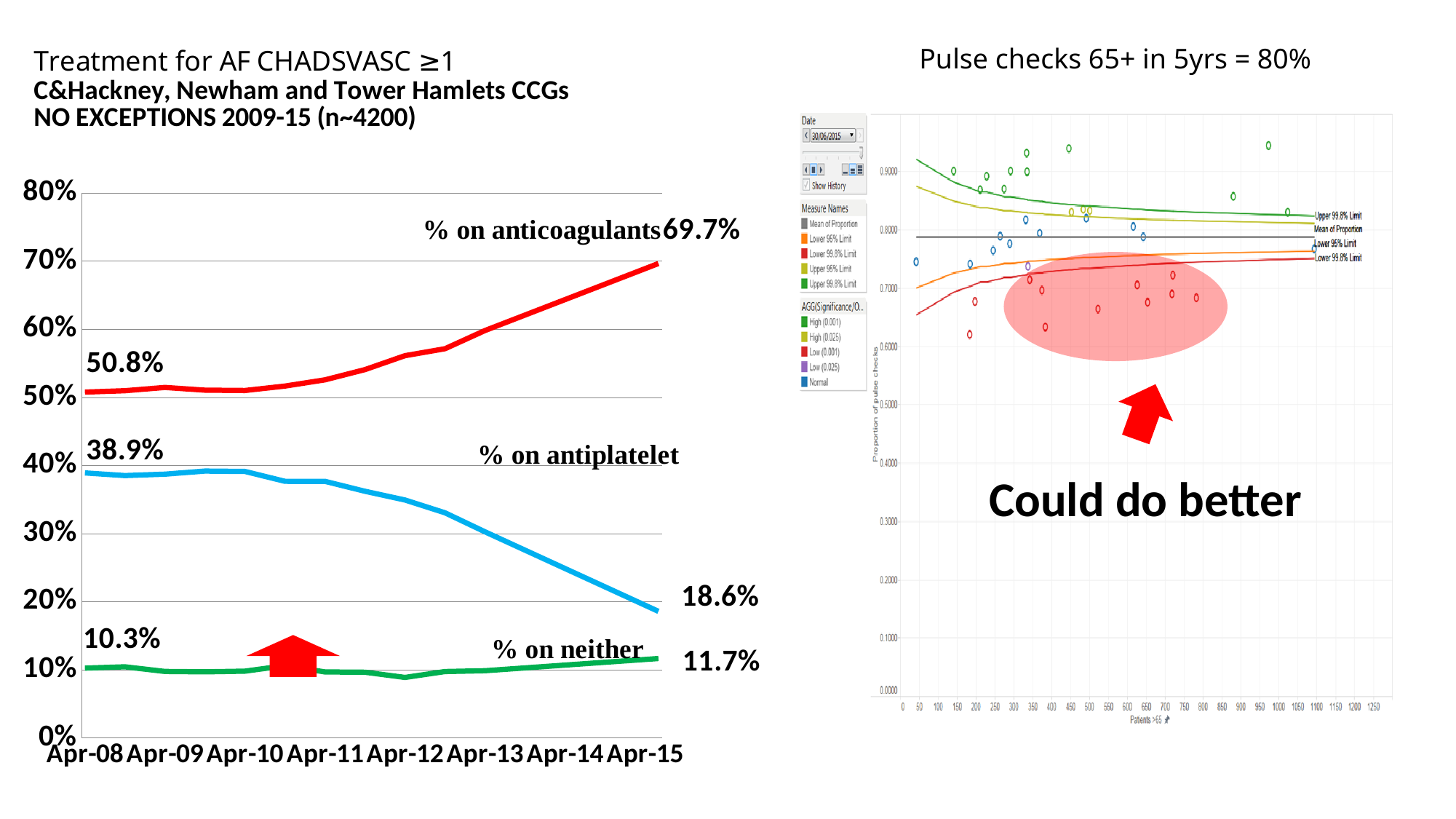
On the 'Treatment for AF CHADSVASC ≥1' chart, which series has the highest value at Apr-15? % on anticoagulants On the 'Treatment for AF CHADSVASC ≥1' chart, by how many percentage points did % on antiplatelet fall from Apr-08 to Apr-15? 20.3 percentage points On the 'Treatment for AF CHADSVASC ≥1' chart, by how many percentage points did % on anticoagulants change from Apr-08 to Apr-15? 18.9 percentage points What kind of chart is the 'Treatment for AF CHADSVASC ≥1' chart? line chart On the 'Treatment for AF CHADSVASC ≥1' chart, what is the value for % on antiplatelet at Apr-08? 38.9% On the 'Treatment for AF CHADSVASC ≥1' chart, what is the value for % on anticoagulants at Apr-08? 50.8% On the 'Treatment for AF CHADSVASC ≥1' chart, what is the value for % on neither at Apr-15? 11.7% On the 'Treatment for AF CHADSVASC ≥1' chart, what is the value for % on anticoagulants at Apr-15? 69.7% On the 'Treatment for AF CHADSVASC ≥1' chart, what is the value for % on antiplatelet at Apr-15? 18.6% On the 'Pulse checks 65+ in 5yrs = 80%' chart, what is the label of the x axis? Patients >65 On the 'Treatment for AF CHADSVASC ≥1' chart, how many series are plotted? 3 On the 'Treatment for AF CHADSVASC ≥1' chart, does % on antiplatelet rise or fall from Apr-08 to Apr-15? fall